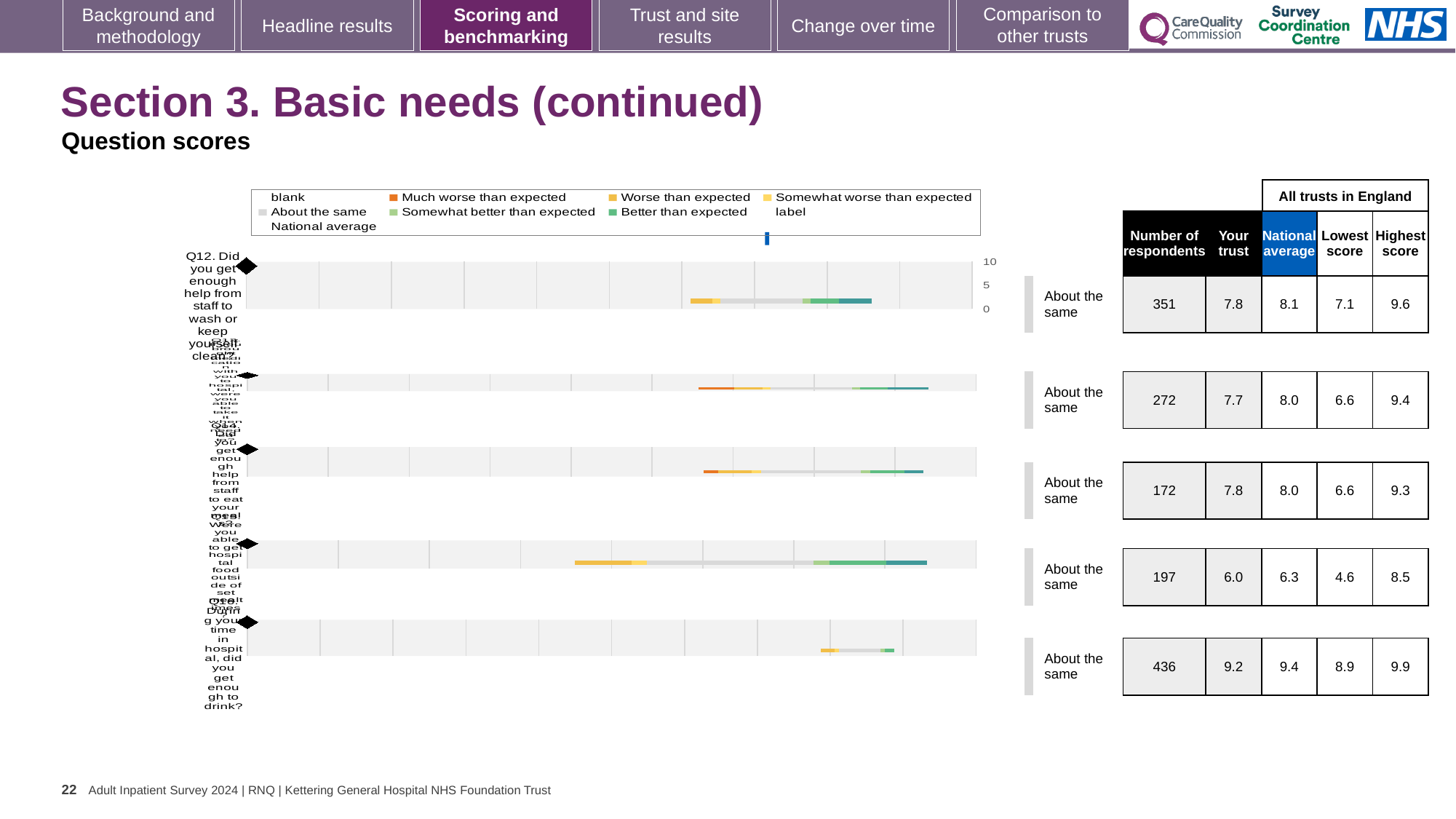
What is the difference between the national average and the 'Your trust' score for Q15 (the fourth bar)? 0.3 What is the 'Your trust' score for Q12 (the first bar, about getting enough help from staff to wash or keep yourself clean)? 7.8 What benchmark category is shown for every question in the chart? About the same Which question has the highest 'Your trust' score? Q16 (did you get enough to drink?) What is the highest score across all trusts in England for Q16 (the last bar)? 9.9 How many respondents are listed for Q16 (the last bar, about getting enough to drink)? 436 How many questions (bars) are plotted in the question scores chart? 5 What is the lowest score across all trusts in England for Q15 (the fourth bar)? 4.6 Which question has the lowest 'Your trust' score? Q15 (hospital food outside of set meal times) Which colour in the legend represents 'Much worse than expected'? Orange What kind of chart is used to show the question scores on this slide? bar chart For Q12 (the first bar), which is larger: the 'Your trust' score or the national average? National average